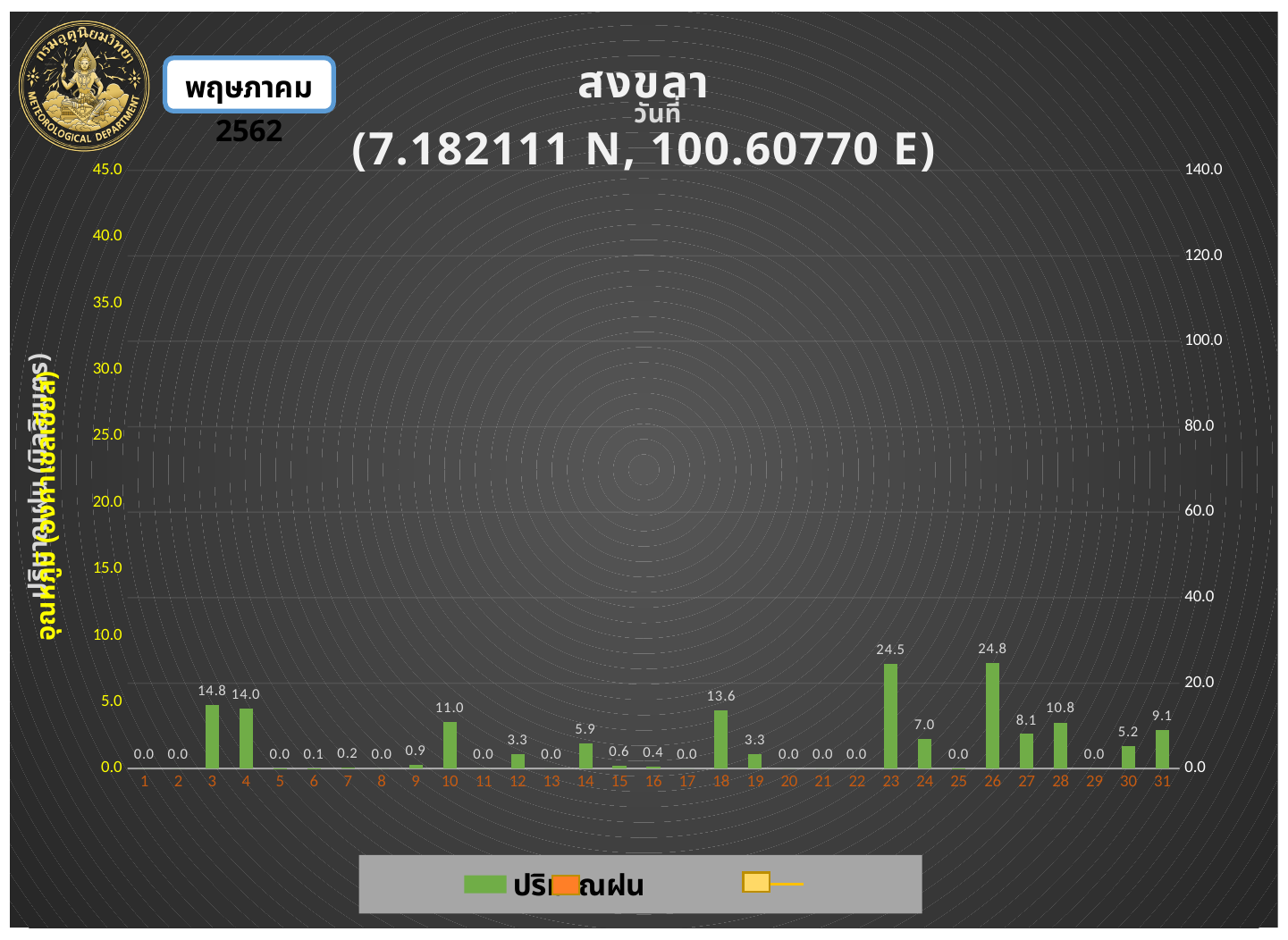
How many days are shown on the x axis? 31 Which has the larger rainfall value, day 18 or day 24? day 18 What is the rainfall value for day 23? 24.5 What kind of chart is shown on the slide? bar chart Is the rainfall value for day 26 greater or less than 20.0 on the right axis? greater What is the difference between the rainfall values for day 3 and day 4? 0.8 What is the rainfall value for day 14? 5.9 What is the difference between the rainfall values for day 26 and day 23? 0.3 Which day has the highest rainfall value? 26 What is the rainfall value for day 3? 14.8 What is the rainfall value for day 18? 13.6 What station name is shown in the chart title? สงขลา